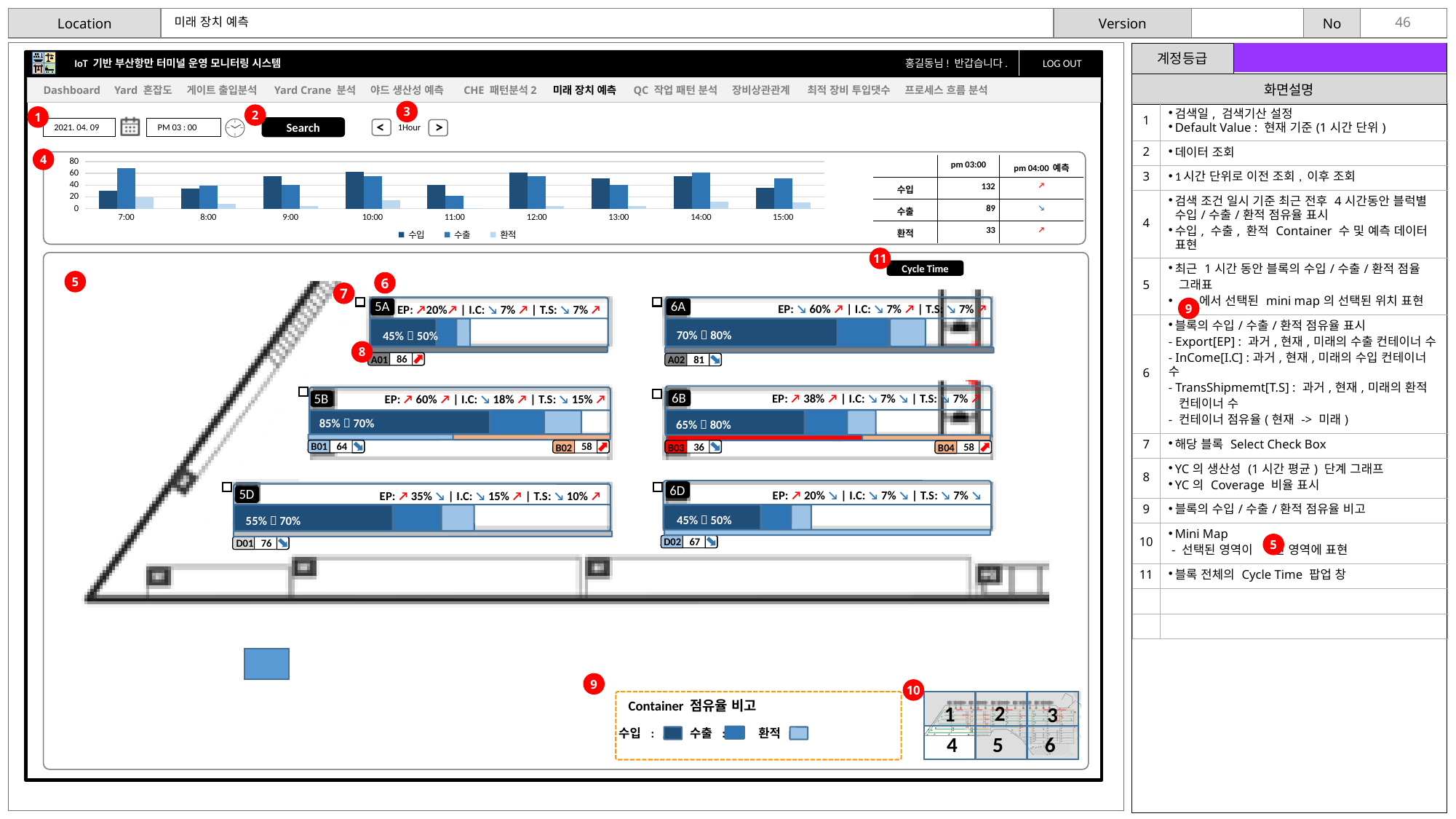
How many series does the legend of the top bar chart list? 3 In the top bar chart, is the 환적 value at 7:00 greater or less than 40? less In the top bar chart, at which time is the 환적 bar highest? 7:00 In the top bar chart, at which time is the 수출 bar highest? 7:00 How many time categories are shown on the x axis of the top bar chart? 9 In the top bar chart, is the 수입 value at 10:00 greater or less than 40? greater In the top bar chart, is the 수출 value at 11:00 greater or less than 40? less What are the legend entries of the top bar chart? 수입, 수출, 환적 In the top bar chart, which is larger at 7:00, 수입 or 수출? 수출 What kind of chart is shown at the top of the screen (item 4)? bar chart In the top bar chart, which is larger at 11:00, 수입 or 수출? 수입 What is the highest tick value shown on the y axis of the top bar chart? 80